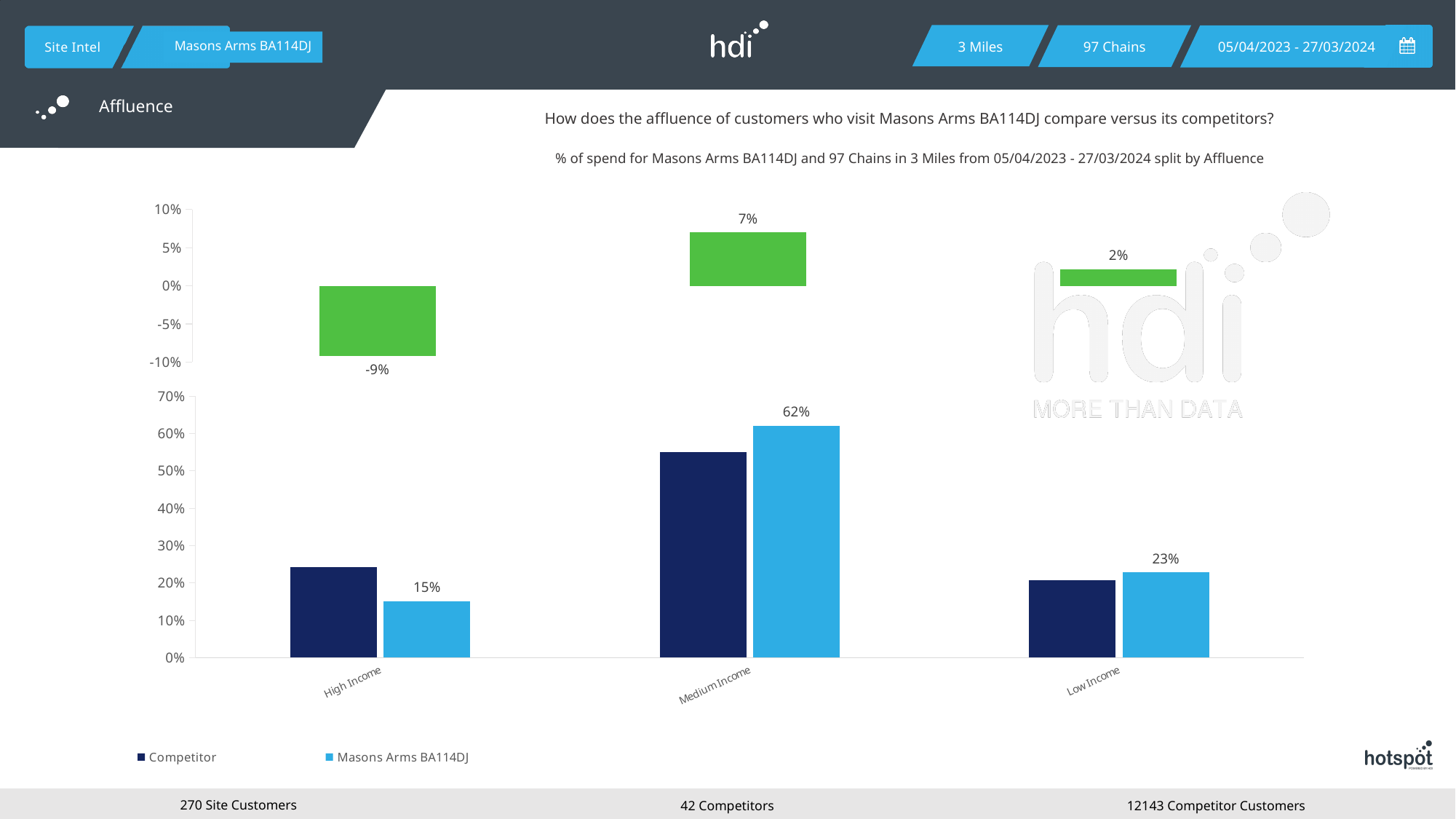
In the bottom chart, what is the value for Masons Arms BA114DJ in the Low Income category? 23% In the bottom chart, what is the difference between the Masons Arms BA114DJ values for Medium Income and Low Income? 39% In the bottom chart, what is the value for Masons Arms BA114DJ in the Medium Income category? 62% In the top chart, which category has the lowest value? High Income In the bottom chart, what is the value for Masons Arms BA114DJ in the High Income category? 15% What type of chart is the bottom chart? Bar chart In the bottom chart, which category has the highest value for Masons Arms BA114DJ? Medium Income In the bottom chart, which is larger for High Income: the Competitor value or the Masons Arms BA114DJ value? Competitor In the top chart, what is the value shown for High Income? -9% In the bottom chart, is the Competitor value for Medium Income greater or less than 50%? greater In the top chart, what is the value shown for Medium Income? 7% How many series does the legend of the bottom chart list? 2